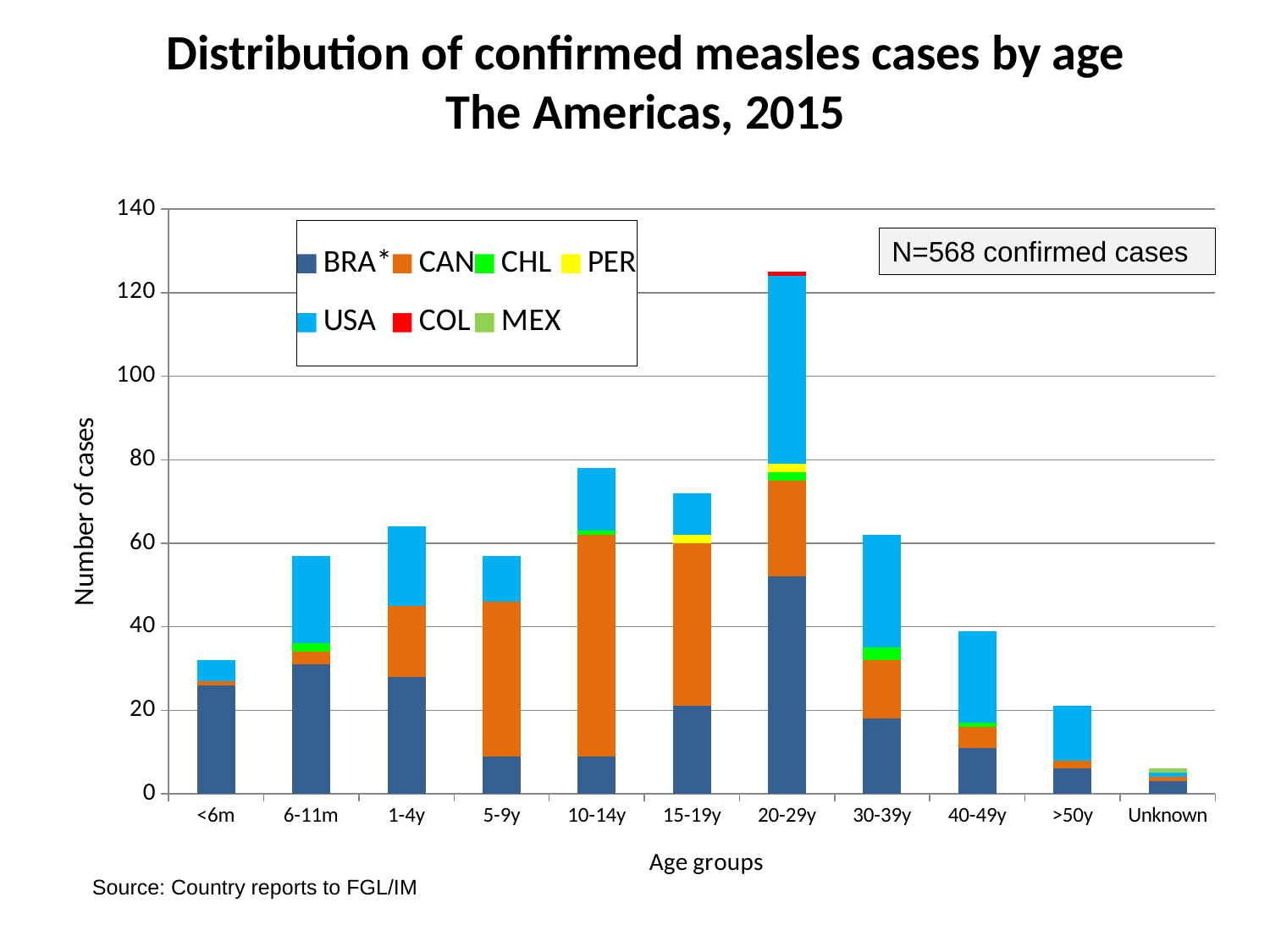
Is the total number of cases for the Unknown age group greater or less than 20? less How many series (countries) does the legend list? 7 Which age group has the highest total number of confirmed measles cases? 20-29y How many age group categories are shown on the x axis? 11 What kind of chart is shown on the slide? Stacked bar chart Which age group has more total cases, 20-29y or 10-14y? 20-29y Is the total number of cases for the 20-29y age group greater or less than 120? greater Which age group has more total cases, <6m or 6-11m? 6-11m Is the total number of cases for the >50y age group greater or less than 40? less According to the text box on the chart, how many confirmed cases are included in total? N=568 confirmed cases Which age group has the lowest total number of confirmed measles cases? Unknown